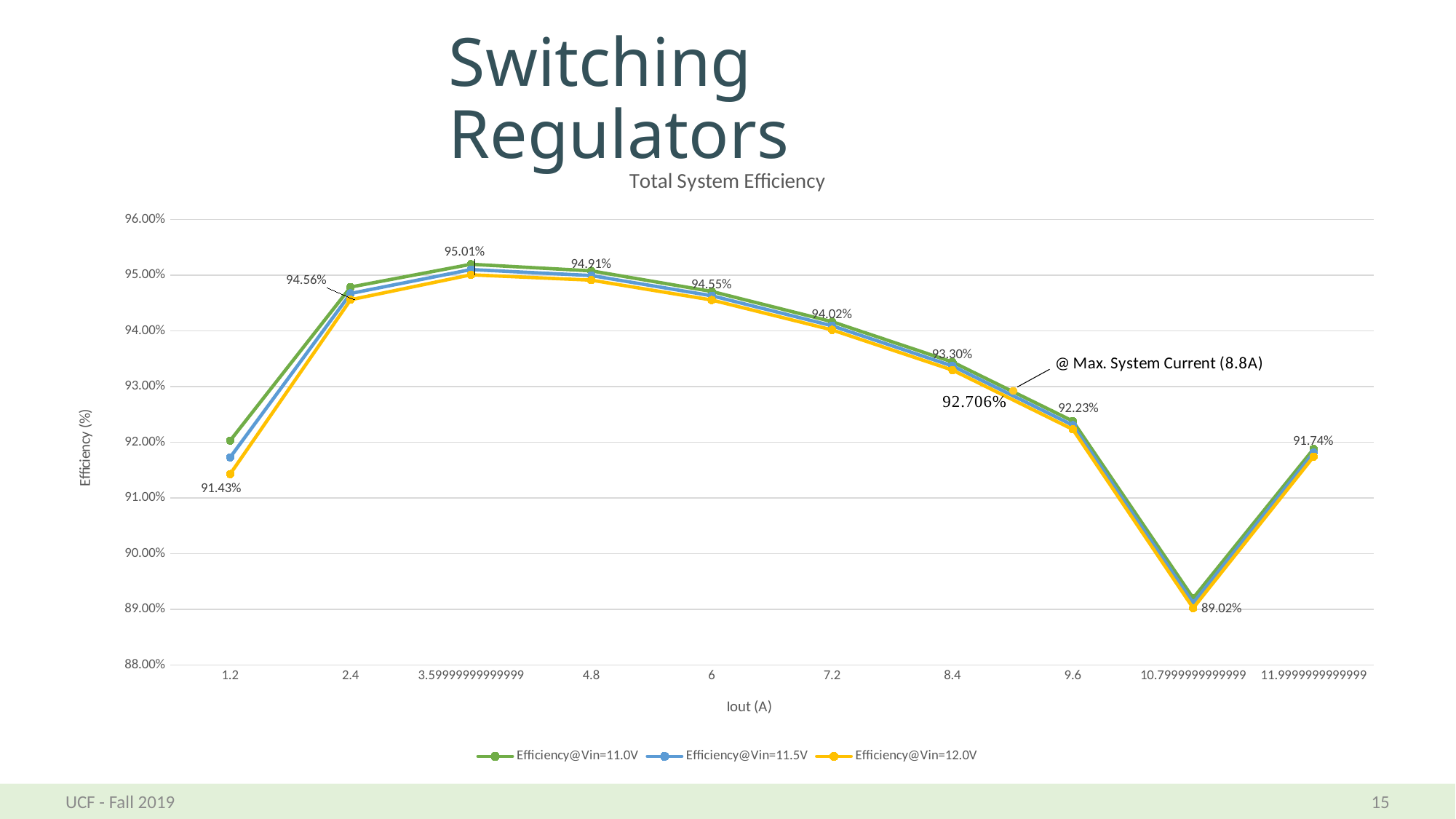
What is the highest labelled efficiency value on the chart? 95.01% Do the efficiency values rise or fall along the x axis between Iout = 3.6 A and Iout = 9.6 A? fall What is the difference between the highest labelled value (95.01%) and the lowest labelled value (89.02%)? 5.99 percentage points What kind of chart is shown on the slide? line chart At which Iout value does the lowest labelled efficiency (89.02%) occur? 10.7999999999999 How many series does the legend list? 3 What efficiency value is labelled at Iout = 10.8 A? 89.02% What efficiency is annotated at the maximum system current (8.8A)? 92.706% Is the Efficiency@Vin=11.0V value at Iout = 10.8 A greater or less than 90.00%? less What efficiency value is labelled at Iout = 1.2 A? 91.43% Which has the larger labelled efficiency, Iout = 4.8 A or Iout = 6 A? 4.8 A How many Iout (A) points are plotted along the x axis? 10